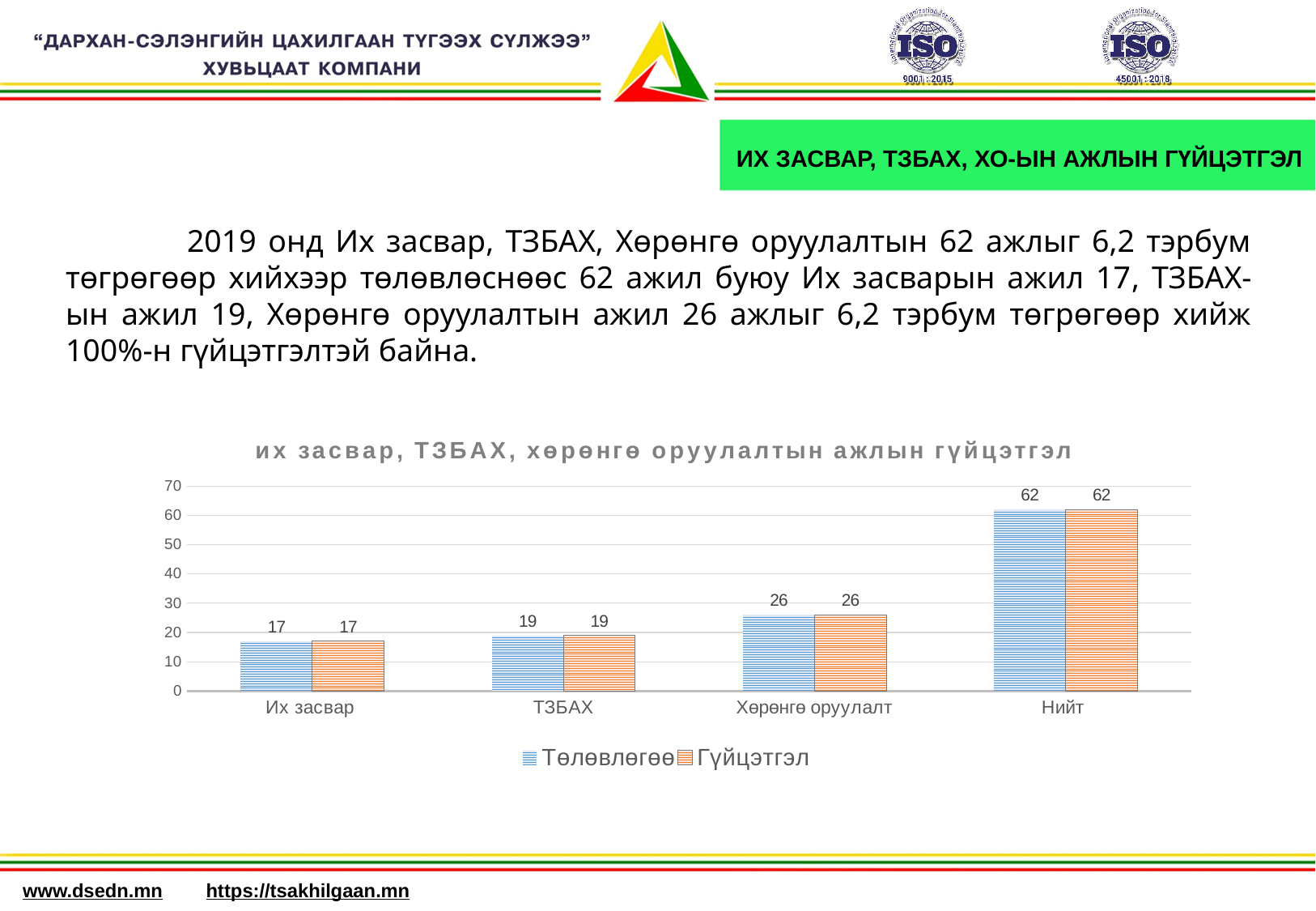
What is the Төлөвлөгөө value for Их засвар? 17 Which category has the highest Төлөвлөгөө value? Нийт What is the Төлөвлөгөө value for Хөрөнгө оруулалт? 26 How many categories are shown on the x axis? 4 What is the Гүйцэтгэл value for Нийт? 62 Which is larger, the Төлөвлөгөө value for ТЗБАХ or for Хөрөнгө оруулалт? Хөрөнгө оруулалт What kind of chart is shown on the slide? Bar chart How many series does the legend list? 2 What is the title of the chart? их засвар, ТЗБАХ, хөрөнгө оруулалтын ажлын гүйцэтгэл What is the Гүйцэтгэл value for ТЗБАХ? 19 Which category has the lowest Гүйцэтгэл value? Их засвар What is the difference between the Гүйцэтгэл values for Хөрөнгө оруулалт and ТЗБАХ? 7